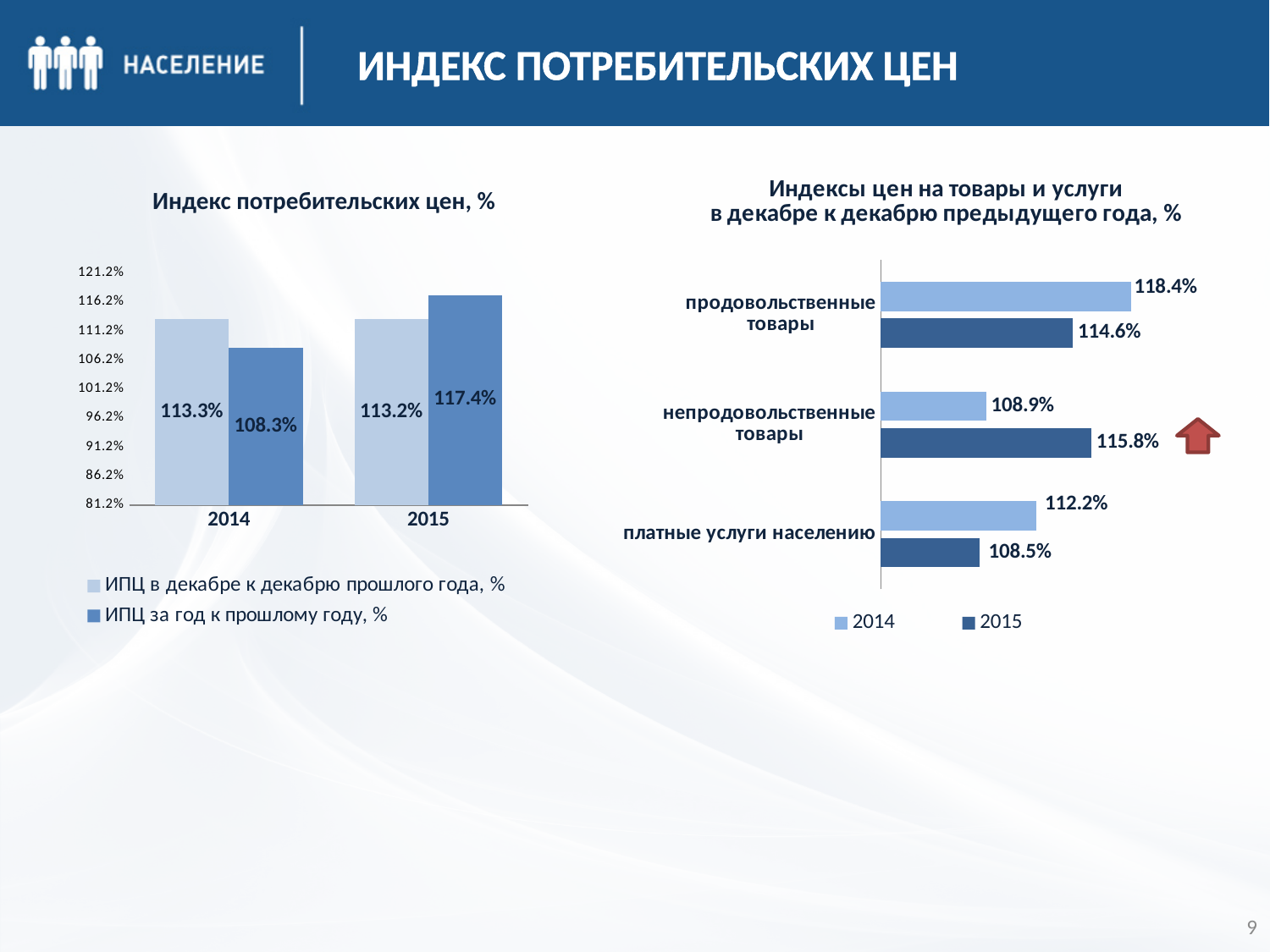
In the chart 'Индекс потребительских цен, %', did 'ИПЦ за год к прошлому году, %' rise or fall from 2014 to 2015? rise In the chart 'Индексы цен на товары и услуги в декабре к декабрю предыдущего года, %', what is the difference between the 2014 and 2015 values for 'продовольственные товары'? 3.8% In the chart 'Индексы цен на товары и услуги в декабре к декабрю предыдущего года, %', what is the 2014 value for 'платные услуги населению'? 112.2% In the chart 'Индексы цен на товары и услуги в декабре к декабрю предыдущего года, %', which category has the lowest 2015 value? платные услуги населению In the chart 'Индексы цен на товары и услуги в декабре к декабрю предыдущего года, %', which is larger for 'непродовольственные товары': the 2014 value or the 2015 value? 2015 What type of chart is 'Индексы цен на товары и услуги в декабре к декабрю предыдущего года, %'? bar chart In the chart 'Индекс потребительских цен, %', what is the difference between the 2015 and 2014 values of 'ИПЦ за год к прошлому году, %'? 9.1% In the chart 'Индексы цен на товары и услуги в декабре к декабрю предыдущего года, %', which category has the highest 2014 value? продовольственные товары In the chart 'Индекс потребительских цен, %', what is the value of 'ИПЦ за год к прошлому году, %' for 2015? 117.4% In the chart 'Индексы цен на товары и услуги в декабре к декабрю предыдущего года, %', what is the 2015 value for 'непродовольственные товары'? 115.8% In the chart 'Индекс потребительских цен, %', how many series does the legend list? 2 In the chart 'Индекс потребительских цен, %', what is the value of 'ИПЦ в декабре к декабрю прошлого года, %' for 2014? 113.3%